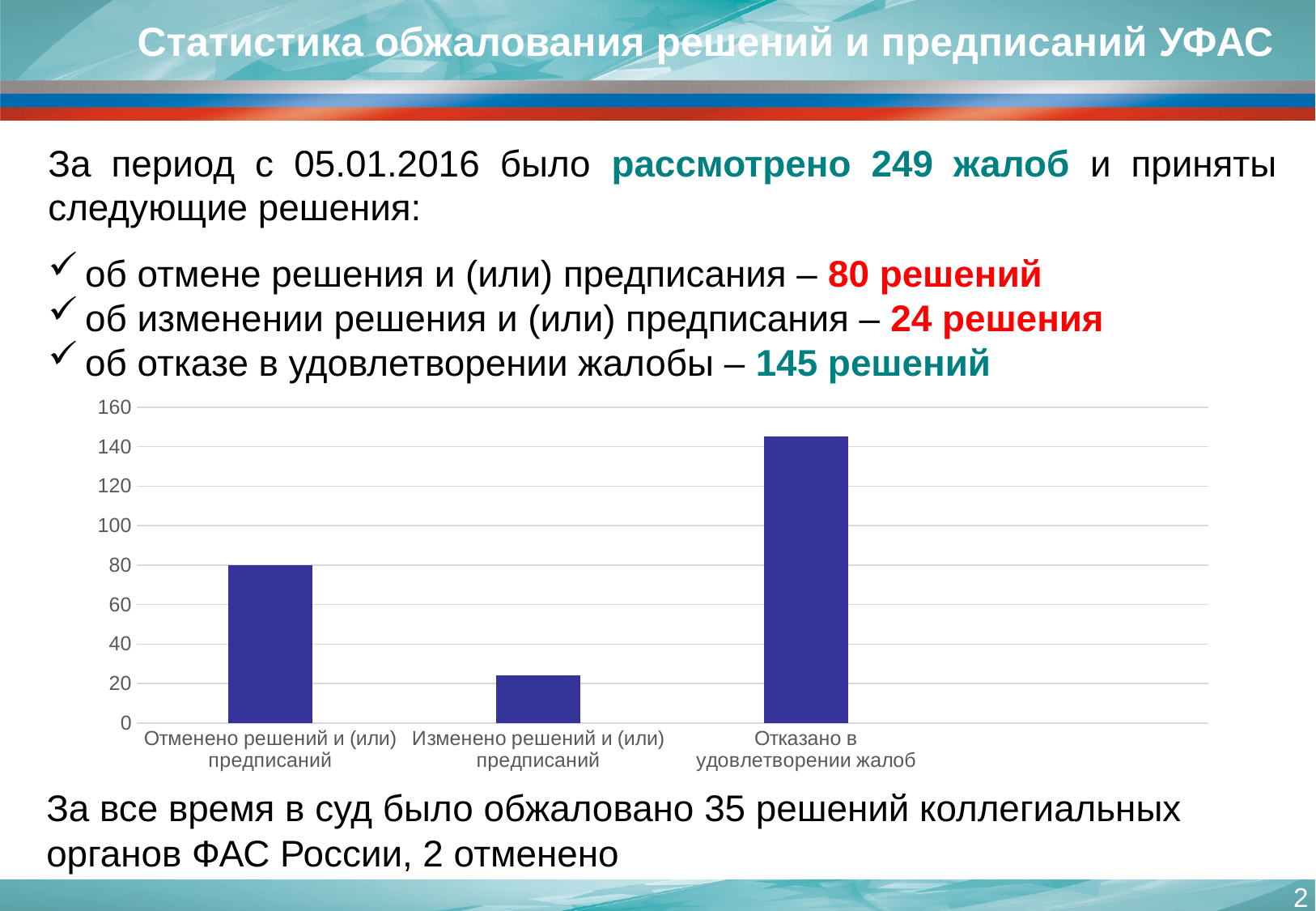
Is the value for 'Изменено решений и (или) предписаний' greater or less than 40? less What is the maximum value shown on the vertical axis of the chart? 160 What type of chart is shown on the slide? bar chart Which category has the lowest bar in the chart? Изменено решений и (или) предписаний Is the value for 'Отказано в удовлетворении жалоб' greater or less than 160? less Is the value for 'Отказано в удовлетворении жалоб' greater or less than 140? greater What colour are the bars in the chart? blue What is the value for 'Отменено решений и (или) предписаний'? 80 Which is larger: the value for 'Отменено решений и (или) предписаний' or the value for 'Изменено решений и (или) предписаний'? Отменено решений и (или) предписаний How many categories are shown on the x axis of the chart? 3 Which category has the highest bar in the chart? Отказано в удовлетворении жалоб What is the difference between the number of refused complaints (145) and the number of cancelled decisions (80) stated on the slide? 65